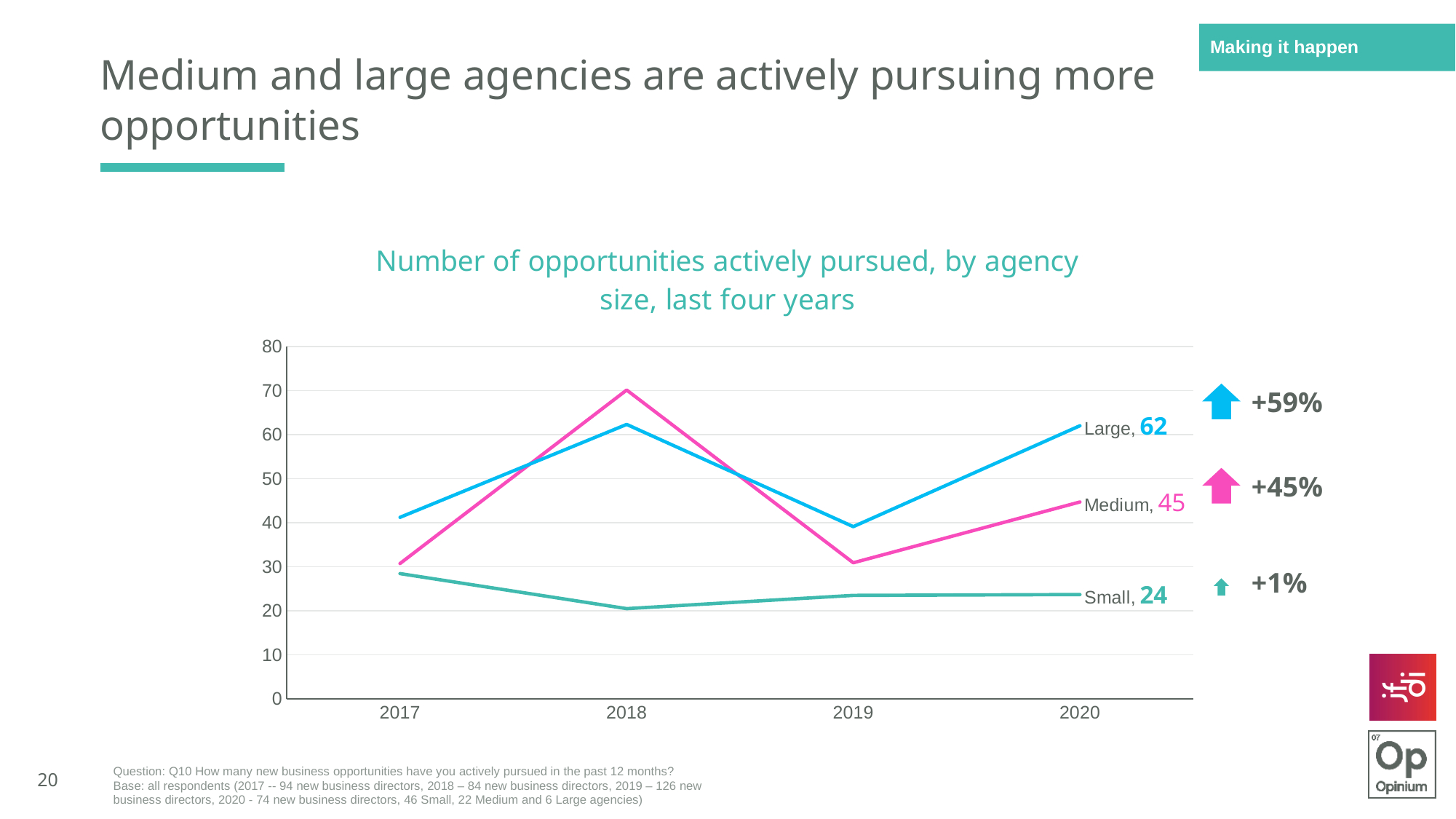
Which agency size has the lowest number of opportunities pursued in 2020? Small Which is larger in 2020, the Medium value or the Small value? Medium What type of chart is shown on the slide? Line chart How many years are shown on the x axis? 4 What is the number of opportunities actively pursued by Large agencies in 2020? 62 Is the value for Medium agencies in 2018 greater or less than 60? greater What is the difference between the Large and Medium values in 2020? 17 How many series (lines) are plotted on the chart? 3 What is the number of opportunities actively pursued by Medium agencies in 2020? 45 Which agency size has the highest number of opportunities pursued in 2020? Large What is the number of opportunities actively pursued by Small agencies in 2020? 24 Is the value for Small agencies in 2018 greater or less than 30? less